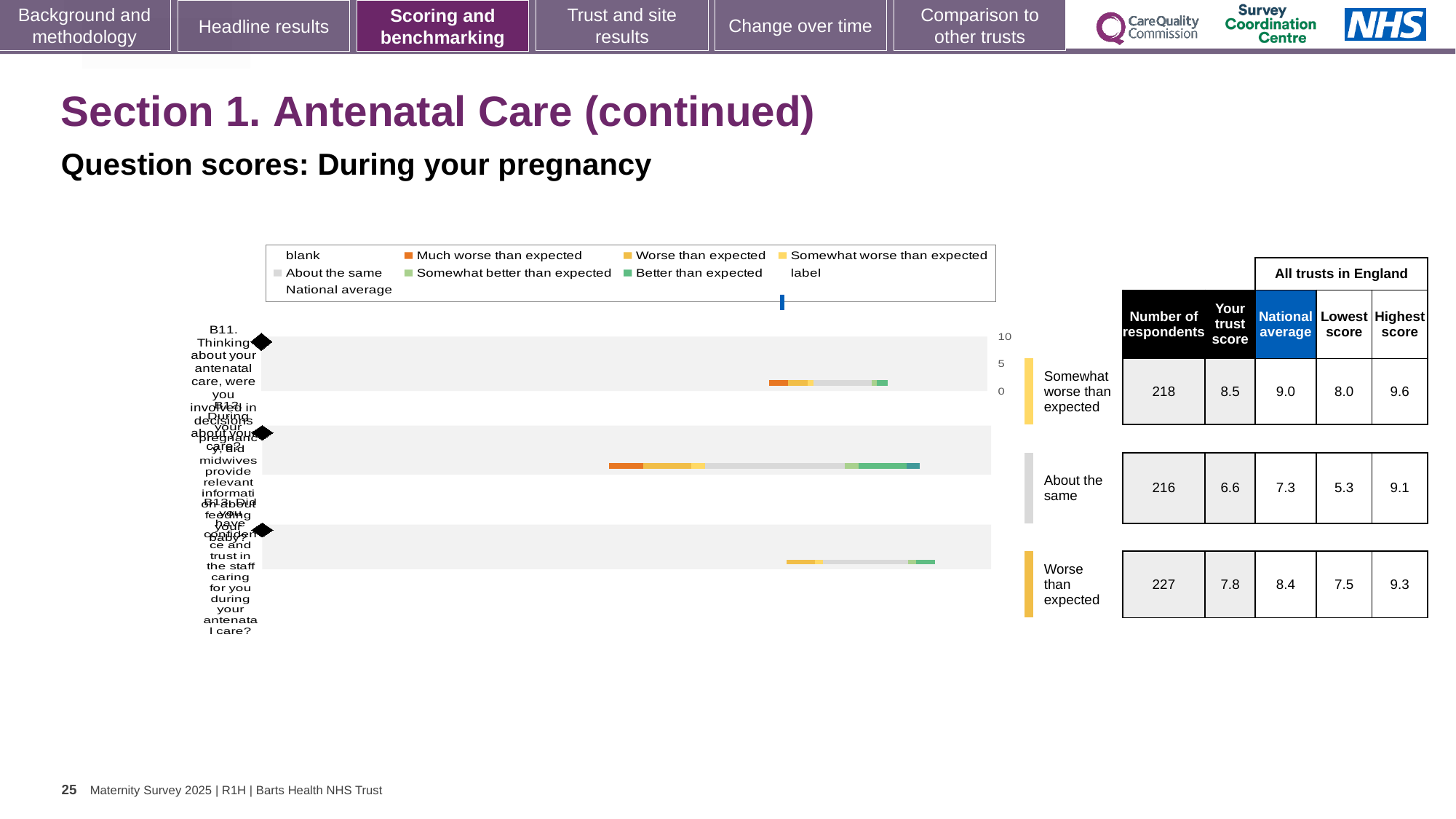
How many more respondents answered question B13 than question B12? 11 What is the trust score for question B11 (involved in decisions about your care)? 8.5 How many respondents answered question B13 (confidence and trust in staff during antenatal care)? 227 Which benchmark category is question B13 placed in? Worse than expected How many questions (bars) are plotted in the chart? 3 What is the highest score among all trusts in England for question B11? 9.6 Which question has the lowest trust score? B12 For question B12, which is larger: the trust score or the national average? national average What kind of chart is shown on the slide? bar chart What is the difference between the national average and the trust score for question B11? 0.5 Which question has the highest trust score? B11 What is the national average for question B12 (midwives providing information about feeding your baby)? 7.3